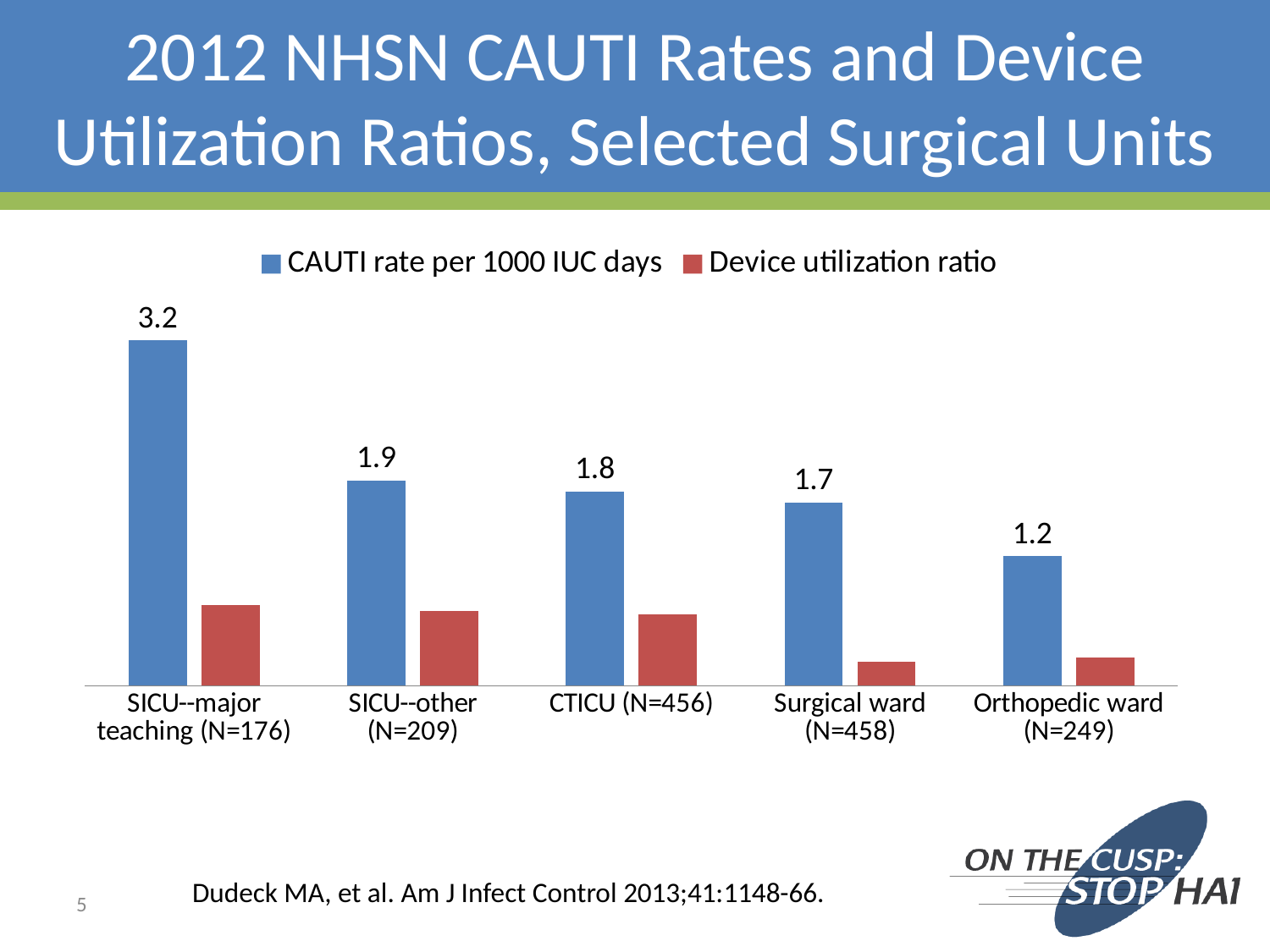
Which has a higher CAUTI rate per 1000 IUC days, SICU--other (N=209) or Surgical ward (N=458)? SICU--other (N=209) What is the CAUTI rate per 1000 IUC days for CTICU (N=456)? 1.8 What is the CAUTI rate per 1000 IUC days for SICU--major teaching (N=176)? 3.2 Which unit has the lowest CAUTI rate per 1000 IUC days? Orthopedic ward (N=249) What is the difference in CAUTI rate per 1000 IUC days between SICU--major teaching (N=176) and SICU--other (N=209)? 1.3 How many series does the legend list? 2 What is the CAUTI rate per 1000 IUC days for Orthopedic ward (N=249)? 1.2 Which has a higher device utilization ratio, SICU--major teaching (N=176) or Surgical ward (N=458)? SICU--major teaching (N=176) How many units are shown on the x axis of the chart? 5 Which unit has the highest CAUTI rate per 1000 IUC days? SICU--major teaching (N=176) Does the CAUTI rate per 1000 IUC days rise or fall from left to right across the units? Fall What kind of chart is shown on the slide? Bar chart